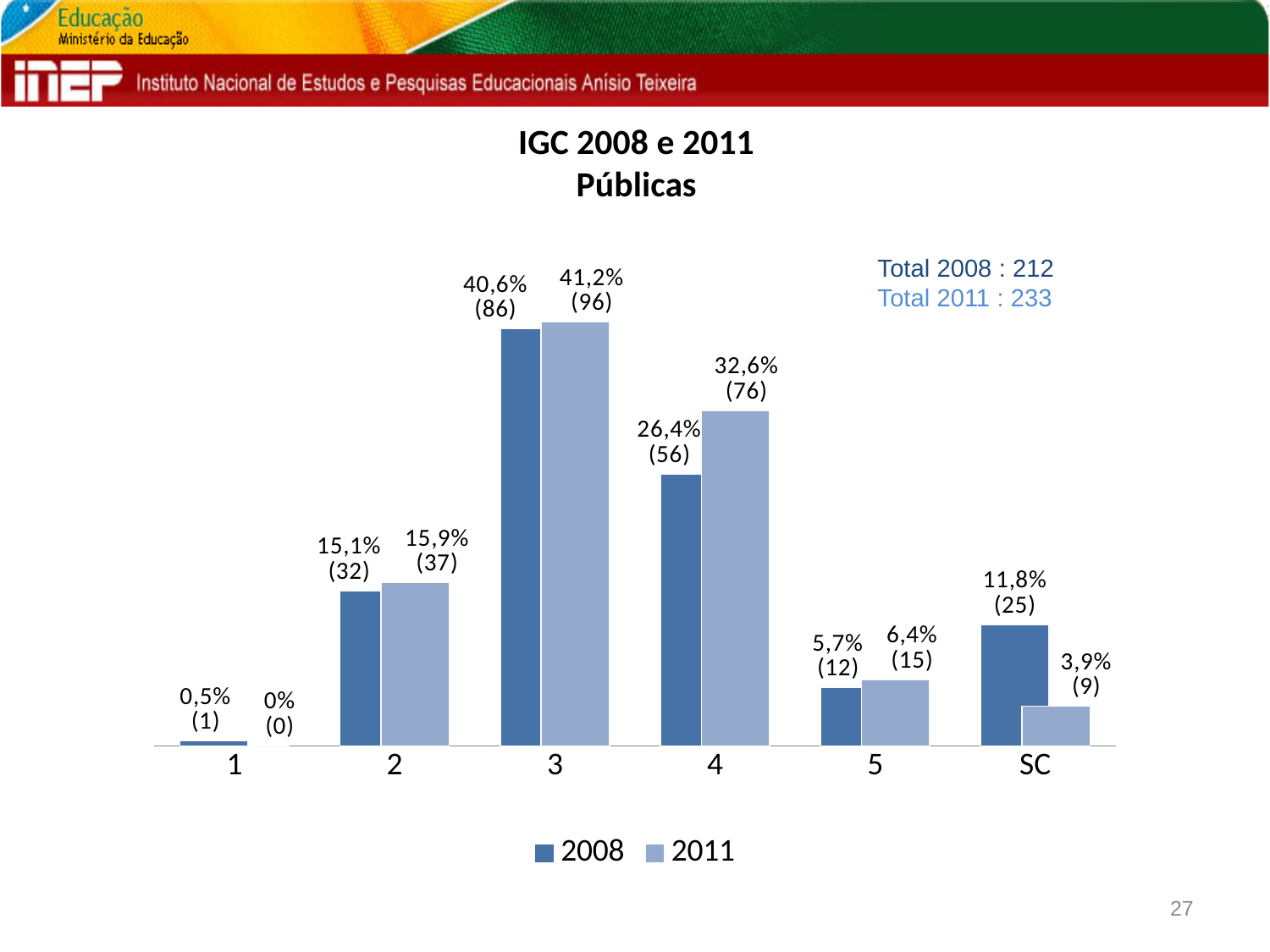
What is the 2011 value for category 4? 32,6% (76) What is the title of the chart? IGC 2008 e 2011 Públicas What is the total for 2011 stated on the slide? 233 How many categories are shown on the x axis? 6 Which category has the highest 2011 value? 3 What kind of chart is shown on the slide? Bar chart How many series does the legend list? 2 What is the 2011 value for category SC? 3,9% (9) What is the 2008 value for category 3? 40,6% (86) For category SC, which series has the larger value, 2008 or 2011? 2008 Which category has the lowest 2008 value? 1 What is the difference in count between 2011 and 2008 for category 4? 20